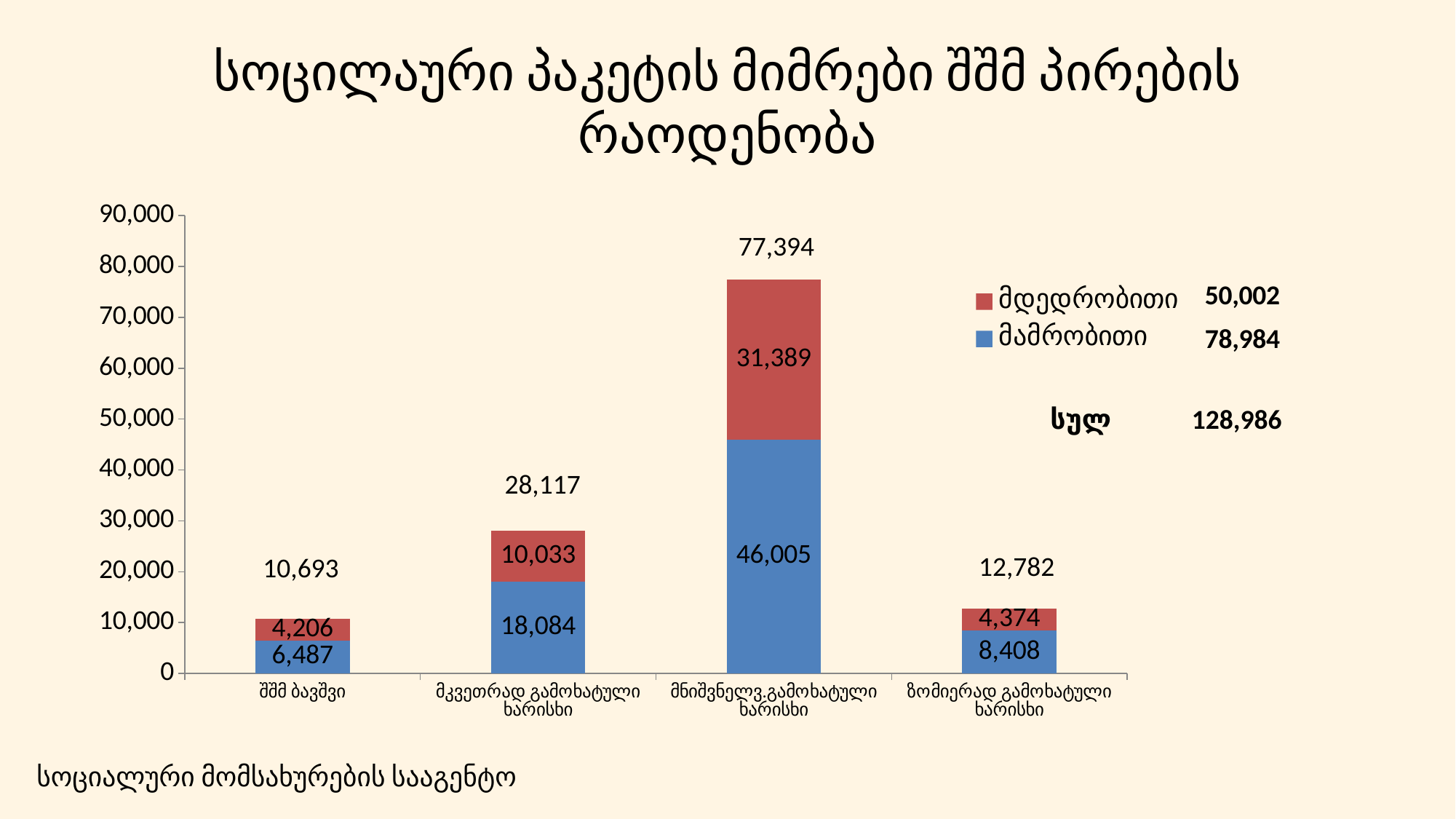
What is the value of მამრობითი for შშმ ბავშვი? 6,487 What overall total (სულ) is shown next to the legend? 128,986 What is the difference between the მამრობითი and მდედრობითი values for ზომიერად გამოხატული ხარისხი? 4,034 How many series does the legend list? 2 What is the total of the stacked bar for მნიშვნელოვ. გამოხატული ხარისხი? 77,394 What type of chart is shown on the slide? stacked bar chart Which category has the lowest total? შშმ ბავშვი Which colour represents მდედრობითი in the legend? red Which is larger for მკვეთრად გამოხატული ხარისხი: მამრობითი or მდედრობითი? მამრობითი Which category has the highest total? მნიშვნელვ.გამოხატული ხარისხი How many categories are shown on the x axis? 4 What is the value of მდედრობითი for მკვეთრად გამოხატული ხარისხი? 10,033